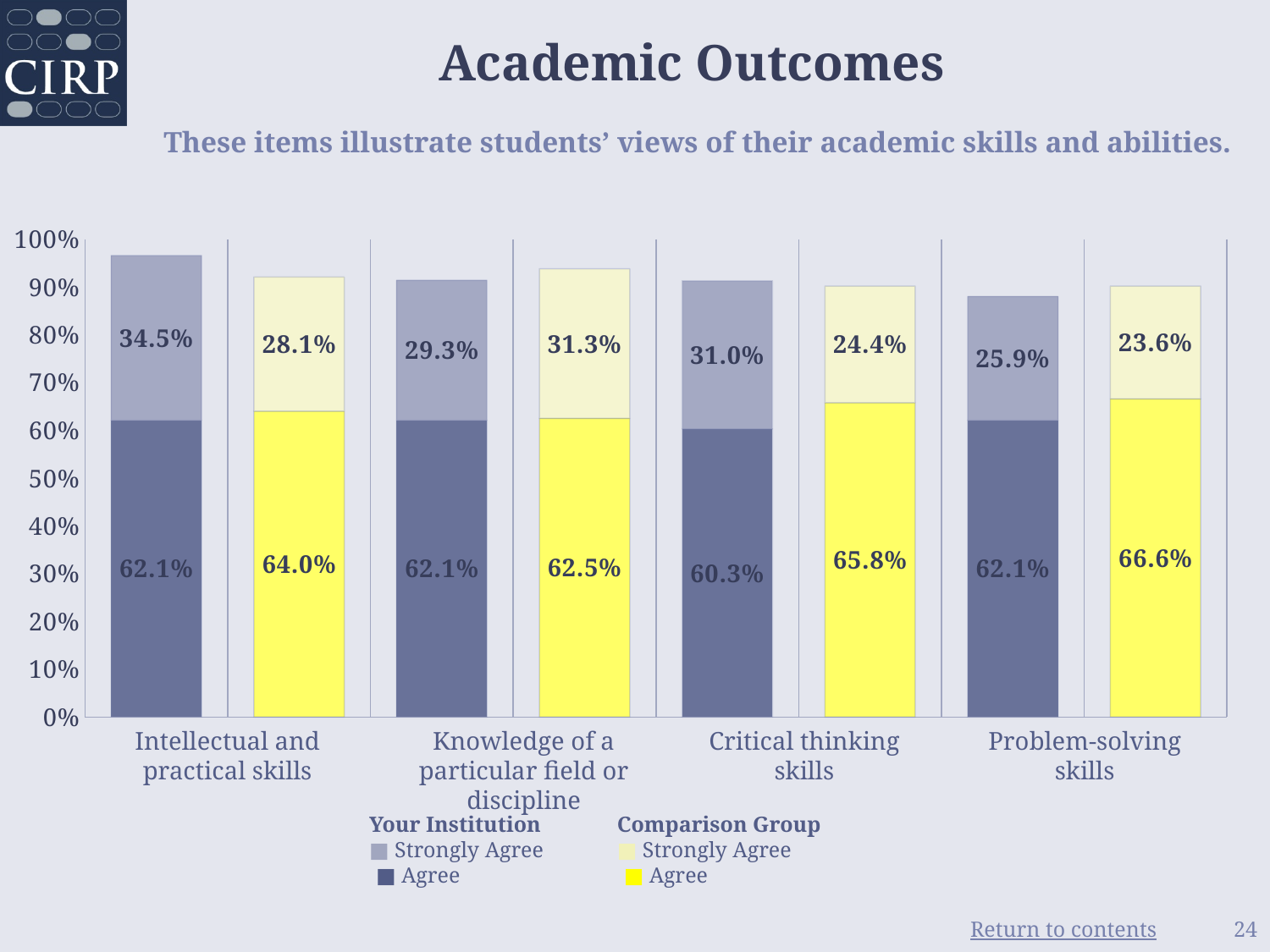
What is the combined Agree and Strongly Agree total for the Comparison Group on Problem-solving skills? 90.2% For Intellectual and practical skills, which is larger: the Your Institution Strongly Agree value or the Comparison Group Strongly Agree value? Your Institution Strongly Agree Which category has the highest Your Institution Strongly Agree value? Intellectual and practical skills What is the Comparison Group's Agree value for Problem-solving skills? 66.6% What is the Your Institution Agree value for Critical thinking skills? 60.3% How many categories are shown on the x axis of the chart? 4 What is the Comparison Group's Strongly Agree value for Knowledge of a particular field or discipline? 31.3% What percentage of students at Your Institution strongly agree for Intellectual and practical skills? 34.5% What kind of chart is shown on the slide? Stacked bar chart What is the difference between the Comparison Group Agree value and the Your Institution Agree value for Critical thinking skills? 5.5% What is the combined Agree and Strongly Agree total for Your Institution on Intellectual and practical skills? 96.6% Which category has the lowest Comparison Group Strongly Agree value? Problem-solving skills